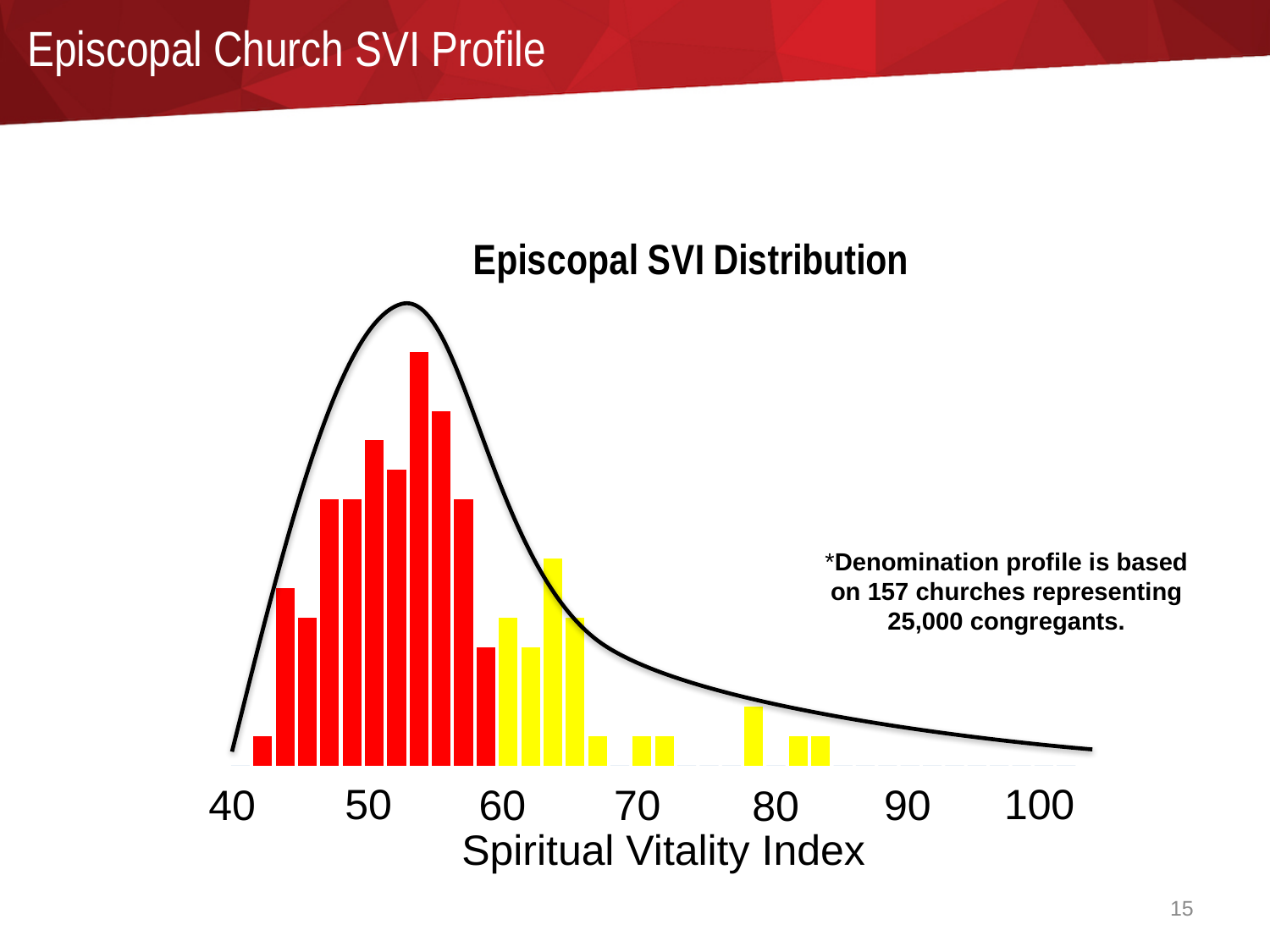
Do the bar heights generally rise or fall as the Spiritual Vitality Index increases from 60 to 100? fall What type of chart is shown on the slide? Bar chart Which is taller: the tallest red bar or the tallest yellow bar? The tallest red bar What is the title of the chart? Episcopal SVI Distribution Do the bar heights generally rise or fall as the Spiritual Vitality Index increases from 40 to about 54? rise Which is taller: the bar just below 55 or the bar just above 65? The bar just below 55 Is the tallest bar located at a Spiritual Vitality Index greater or less than 60? less Between which two x-axis tick values does the tallest bar fall? Between 50 and 60 What is the label of the x axis? Spiritual Vitality Index